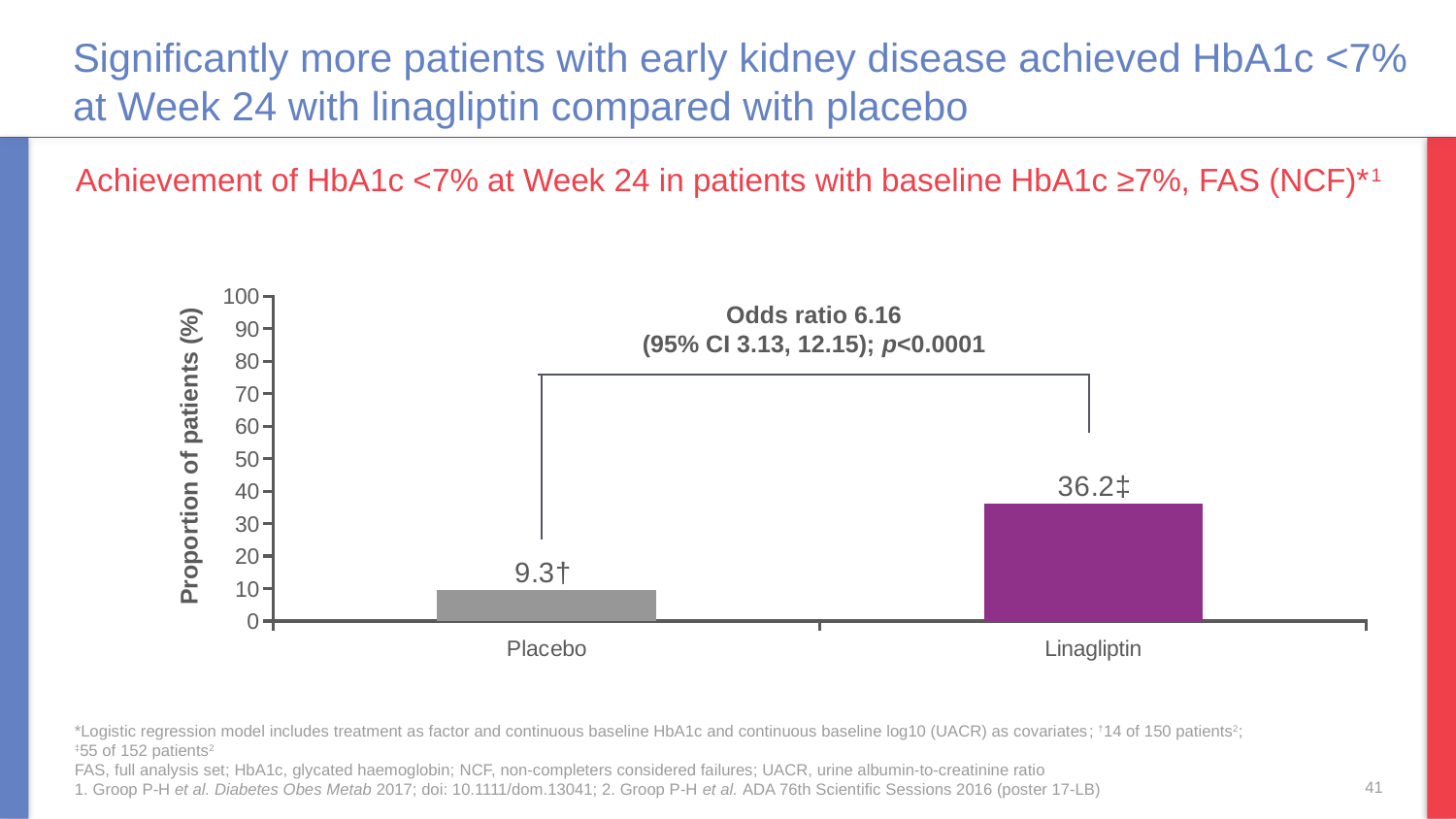
What is the label of the y-axis? Proportion of patients (%) Is the value for Linagliptin greater or less than 30? greater What is the proportion of patients achieving HbA1c <7% at Week 24 in the Placebo group? 9.3 What is the proportion of patients achieving HbA1c <7% at Week 24 in the Linagliptin group? 36.2 What is the difference in proportion of patients between the Linagliptin and Placebo groups? 26.9 Which group has the lower proportion of patients achieving HbA1c <7%? Placebo How many treatment groups are shown on the chart? 2 What odds ratio is reported on the chart? 6.16 What type of chart is shown on the slide? Bar chart Which group has the higher proportion of patients achieving HbA1c <7%? Linagliptin Is the value for Placebo larger or smaller than the value for Linagliptin? smaller Is the value for Placebo greater or less than 10? less